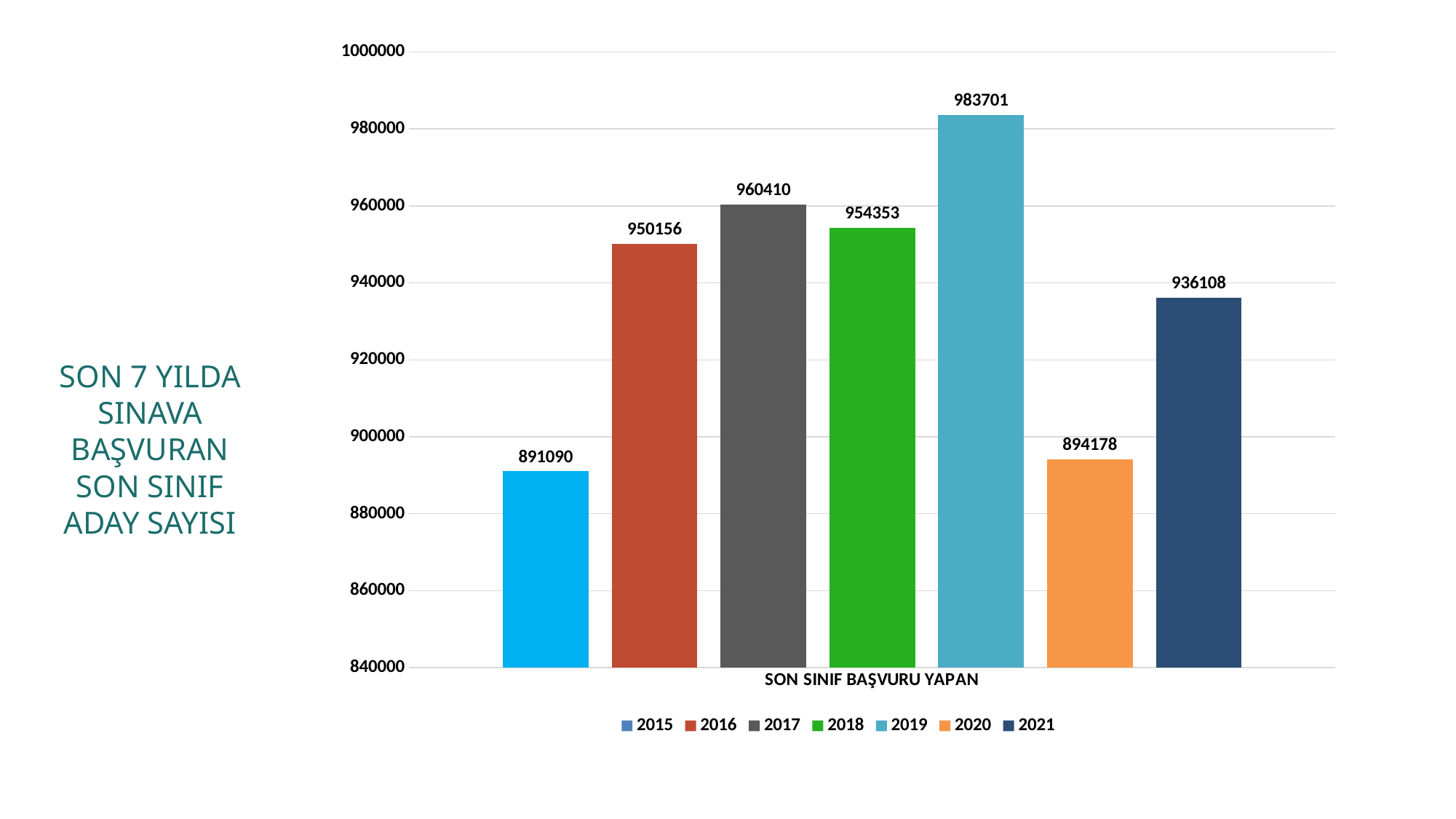
What is the difference between the values for 2019 and 2015? 92611 What is the difference between the values for 2021 and 2020? 41930 Which is larger, the value for 2017 or the value for 2018? 2017 Which year has the highest value? 2019 What is the value for 2019? 983701 Is the value for 2020 greater or less than 900000? less How many series does the legend list? 7 What is the value for 2021? 936108 What is the value for 2015? 891090 What is the value for 2018? 954353 Which year has the lowest value? 2015 What kind of chart is shown on the slide? bar chart